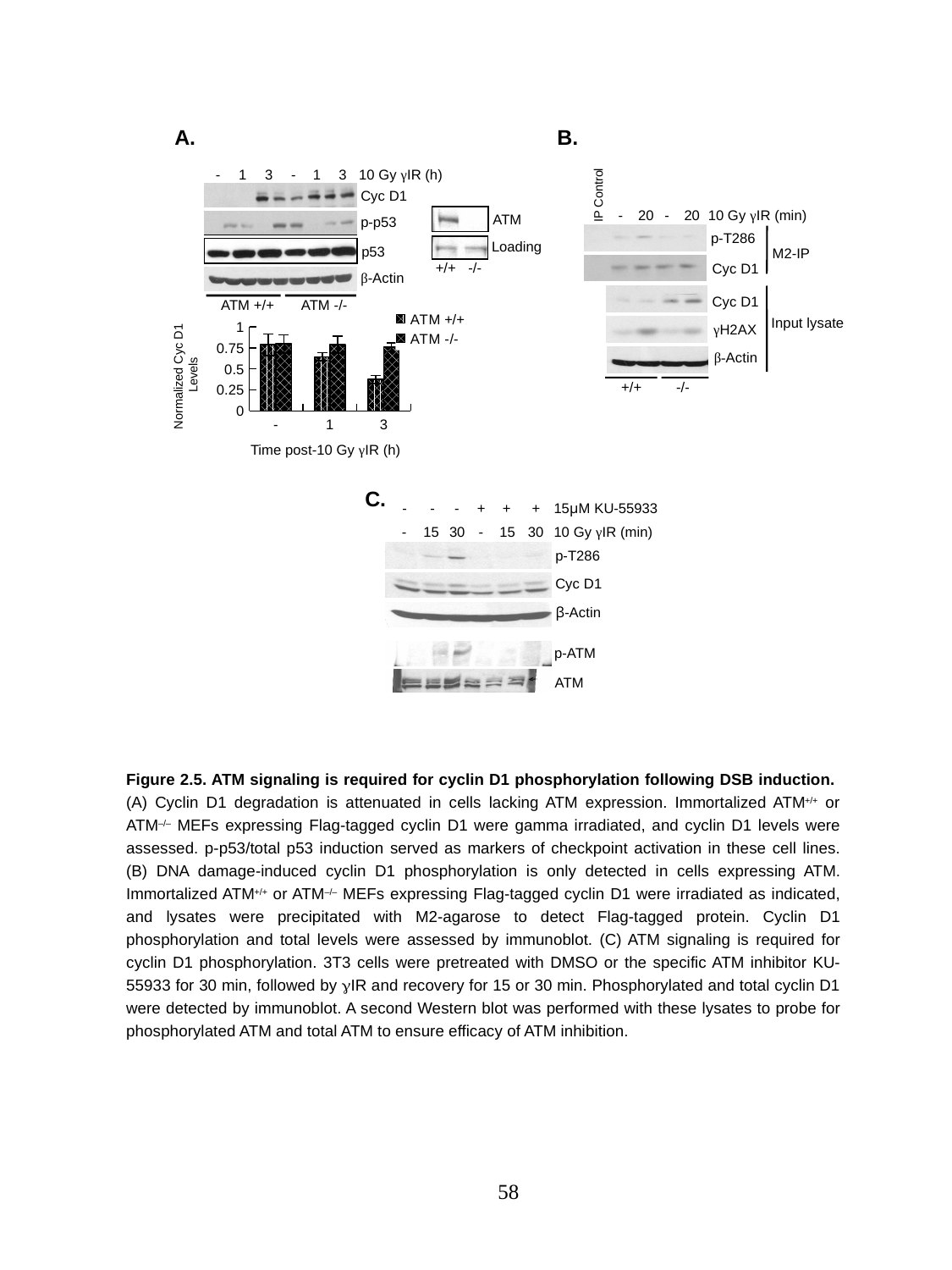
In the bar chart in panel A, at which time point is the ATM +/+ normalized Cyc D1 level lowest? 3 What are the two series named in the legend of the bar chart in panel A? ATM +/+ and ATM -/- In the bar chart in panel A, at 1 h post-irradiation, which series has the larger normalized Cyc D1 level, ATM +/+ or ATM -/-? ATM -/- In the bar chart in panel A, at which time point is the ATM +/+ normalized Cyc D1 level highest? - In the bar chart in panel A, do the ATM +/+ values rise or fall from the untreated (-) time point to 3 h? fall What kind of chart is shown in panel A below the blots? bar chart How many time-point categories are shown on the x axis of the bar chart in panel A? 3 What is the x-axis title of the bar chart in panel A? Time post-10 Gy γIR (h) In the bar chart in panel A, is the ATM -/- value at 3 h greater or less than 0.5? greater How many series does the legend of the bar chart in panel A list? 2 In the bar chart in panel A, at 3 h post-irradiation, which series has the larger normalized Cyc D1 level, ATM +/+ or ATM -/-? ATM -/- In the bar chart in panel A, is the ATM +/+ value at 3 h greater or less than 0.5? less